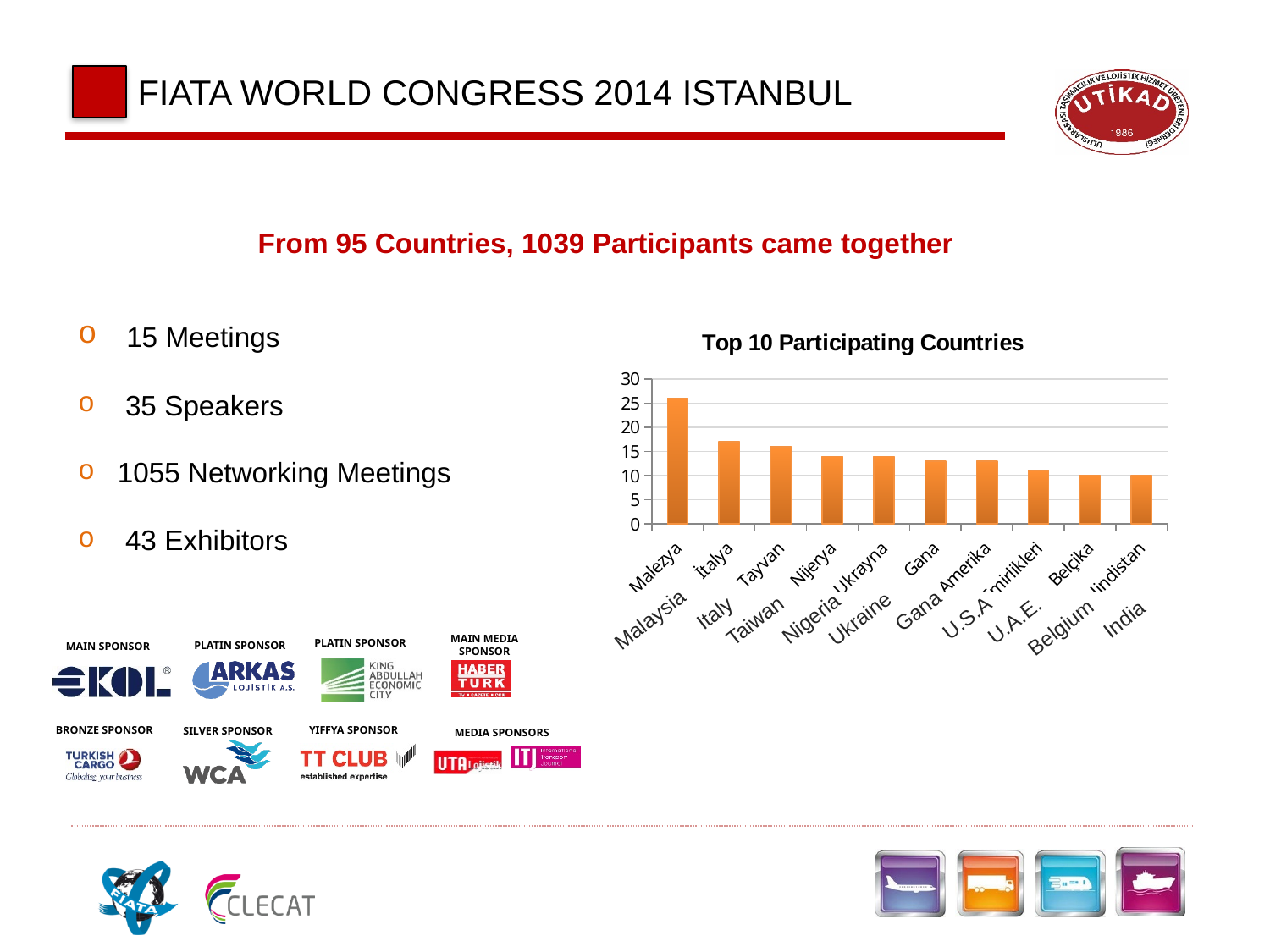
Do the values rise or fall from left to right across the Top 10 Participating Countries chart? fall What is the title of the chart on the slide? Top 10 Participating Countries What kind of chart is used to show the Top 10 Participating Countries? bar chart Is the value for U.A.E. greater or less than 15? less Is the value for Malaysia greater or less than 20? greater How many countries are shown in the Top 10 Participating Countries chart? 10 Which has a larger value, Malaysia or Italy? Malaysia Which has a larger value, Taiwan or Belgium? Taiwan Is the value for India greater or less than 5? greater Which country has the highest bar in the Top 10 Participating Countries chart? Malaysia